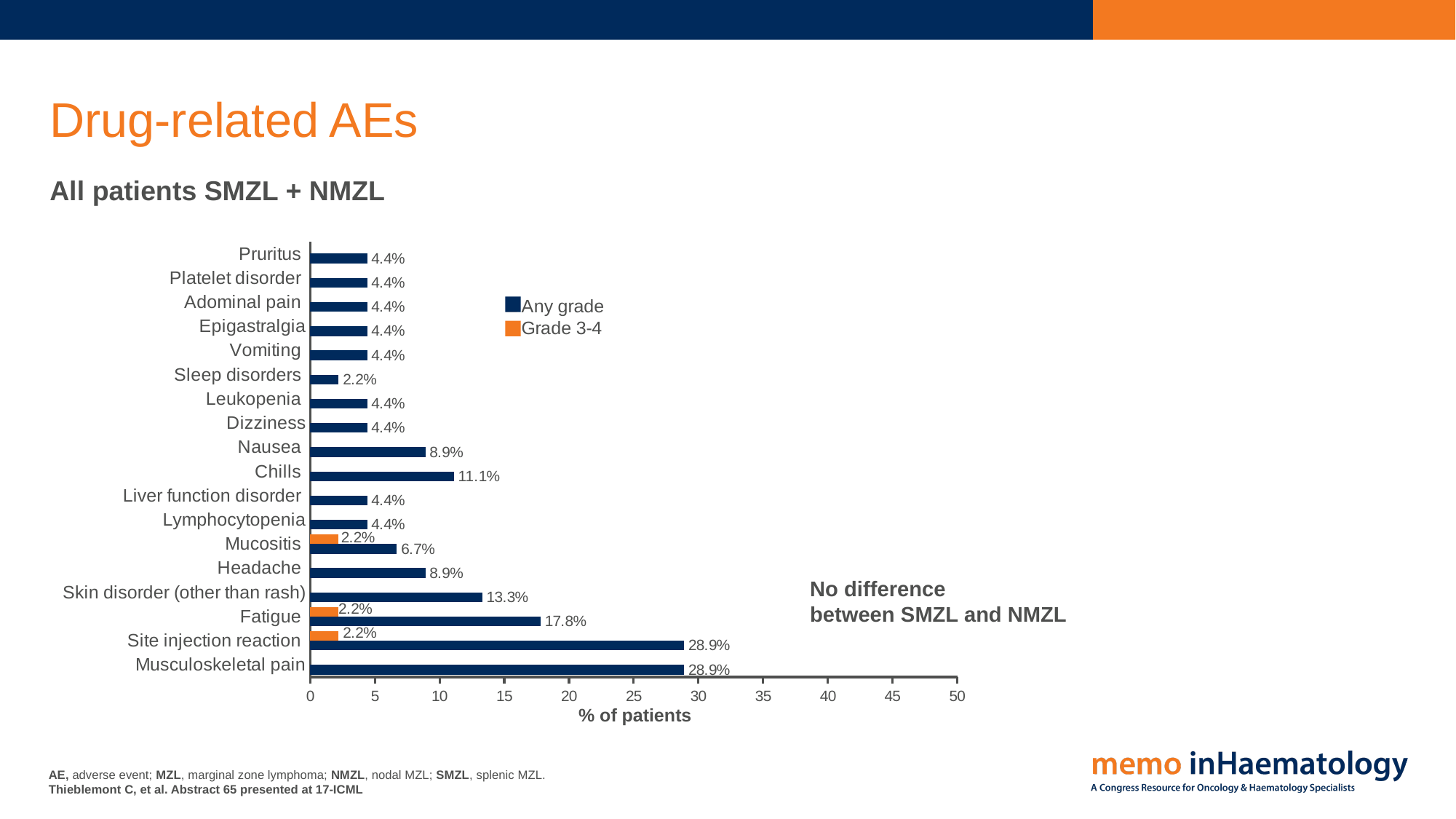
What is the Grade 3-4 value for Site injection reaction? 2.2% What is the difference between the Any grade values for Musculoskeletal pain and Fatigue? 11.1% What is the label of the x axis? % of patients What is the Any grade value for Skin disorder (other than rash)? 13.3% How many adverse event categories are listed on the chart? 18 Is the Any grade value for Site injection reaction greater or less than 25? greater How many series does the legend list? 2 What type of chart is shown on the slide? bar chart What is the Any grade value for Fatigue? 17.8% Which adverse event has the lowest Any grade value? Sleep disorders Which has a higher Any grade value, Nausea or Chills? Chills What is the Any grade value for Chills? 11.1%